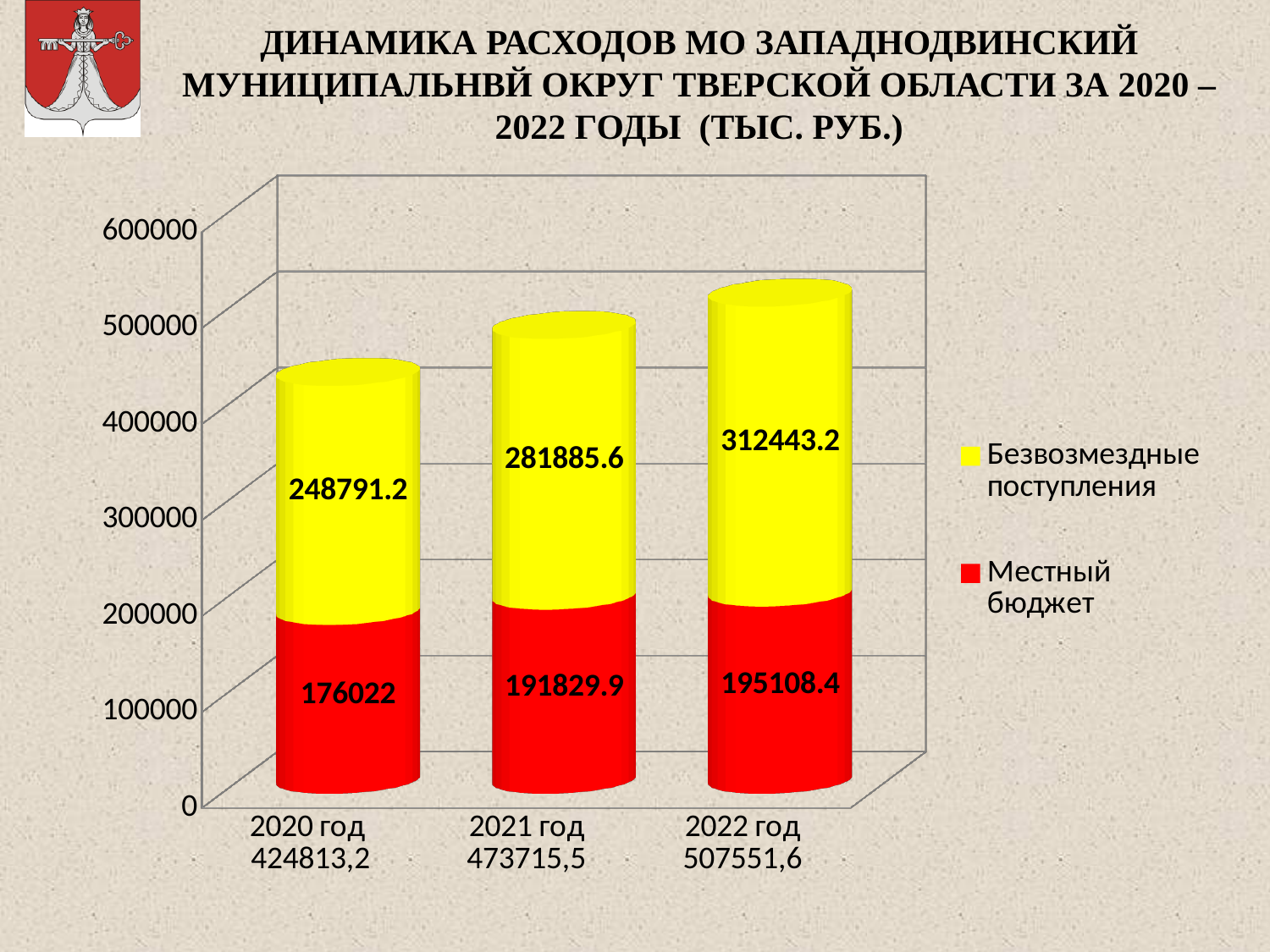
What is the total of the stacked bar for 2020 год? 424813.2 How many series does the legend list? 2 Which is larger: Местный бюджет in 2021 год or Местный бюджет in 2020 год? 2021 год Which year has the highest value for Местный бюджет? 2022 год What kind of chart is shown on the slide? Stacked bar chart How many years are shown on the x axis? 3 Do the values for Безвозмездные поступления rise or fall from 2020 год to 2022 год? Rise What is the value of Местный бюджет for 2020 год? 176022 What is the value of Безвозмездные поступления for 2022 год? 312443.2 What is the value of Безвозмездные поступления for 2021 год? 281885.6 Which year has the lowest value for Безвозмездные поступления? 2020 год What is the difference between Безвозмездные поступления in 2022 год and 2021 год? 30557.6